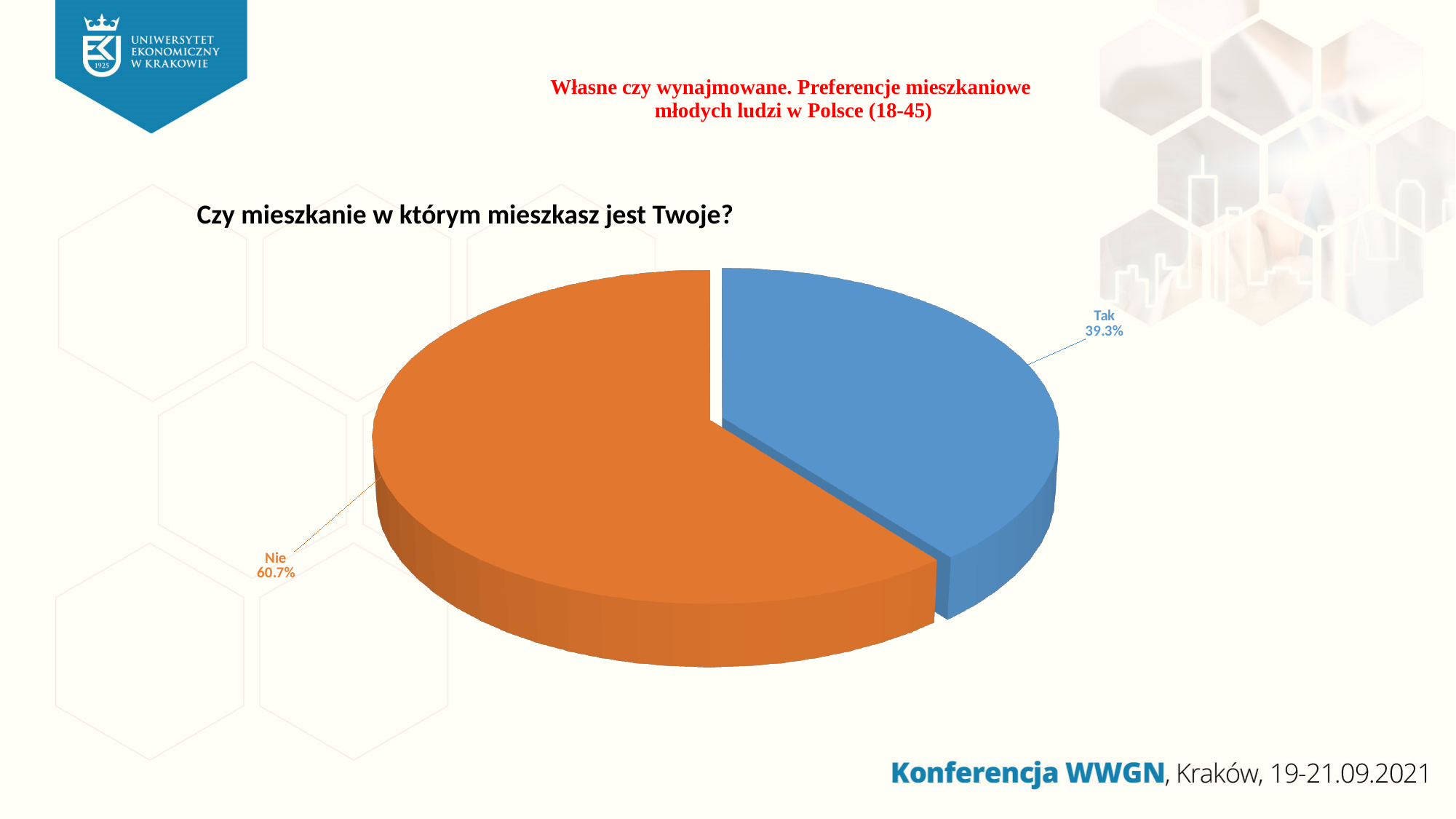
What is the difference in percentage points between the "Nie" and "Tak" slices? 21.4 What share of the pie is labelled "Tak"? 39.3% What kind of chart is shown on the slide? Pie chart What is the title of the chart? Czy mieszkanie w którym mieszkasz jest Twoje? What colour is the "Tak" slice of the pie? Blue Which is larger, the "Tak" slice or the "Nie" slice? Nie Which slice of the pie is the largest? Nie What share of the pie is labelled "Nie"? 60.7% Which slice of the pie is the smallest? Tak How many slices does the pie chart have? 2 Is the share for "Nie" greater or less than 50%? greater What do the two slices of the pie add up to? 100%